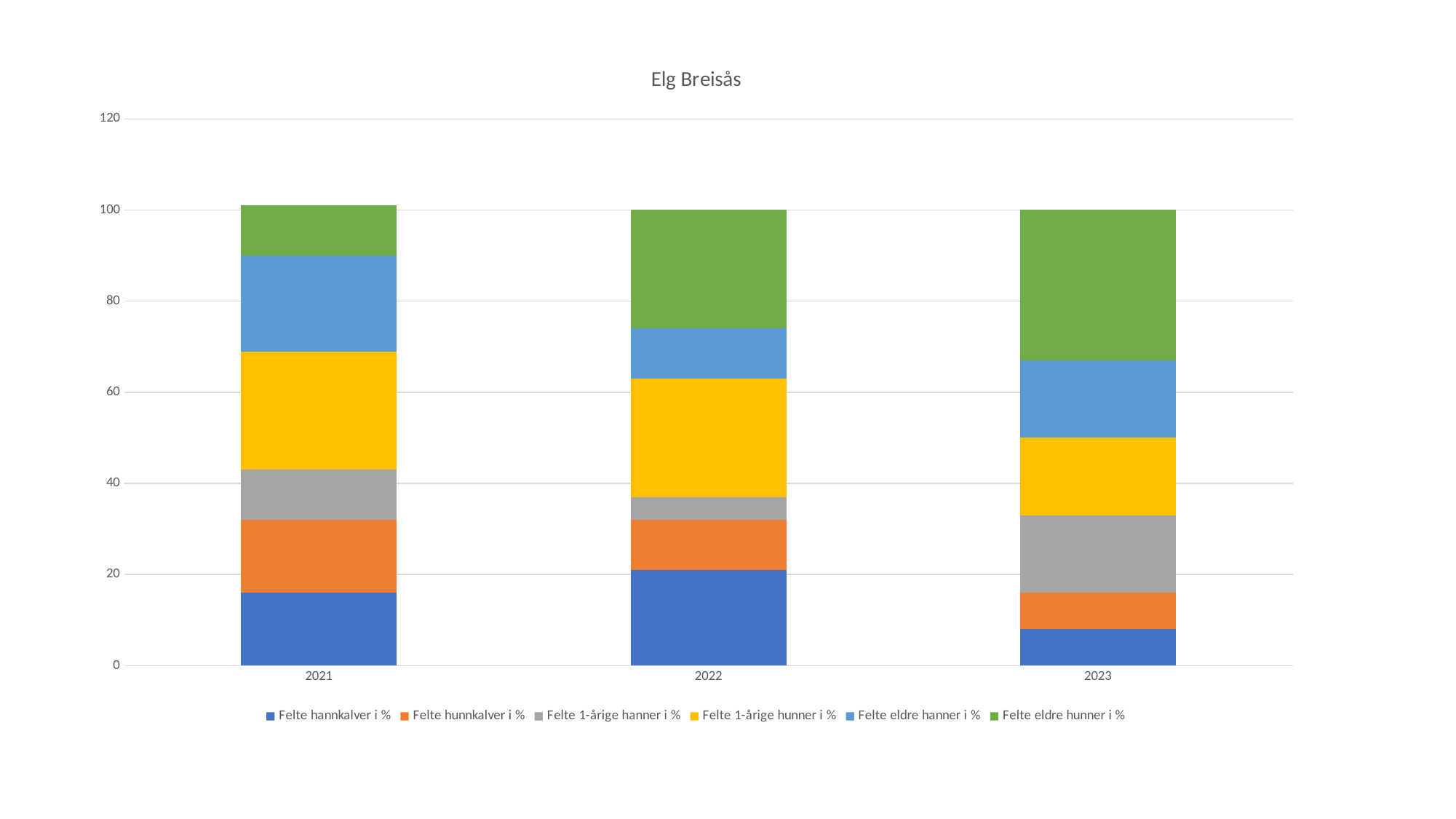
Which year has the largest value for Felte eldre hunner i %? 2023 What is the title of the chart? Elg Breisås How many series does the legend list? 6 Is the value for Felte 1-årige hunner i % in 2021 greater or less than 20? greater How many years are shown on the x axis of the chart? 3 Is the value for Felte hannkalver i % in 2023 greater or less than 20? less What kind of chart is shown on the slide? Stacked bar chart Does the value for Felte hunnkalver i % rise or fall from 2021 to 2023? fall Is the value for Felte eldre hunner i % in 2023 greater or less than 20? greater Which series is shown in green in the chart? Felte eldre hunner i % Which year has the smallest value for Felte 1-årige hanner i %? 2022 Which year has the larger value for Felte eldre hanner i %, 2021 or 2022? 2021